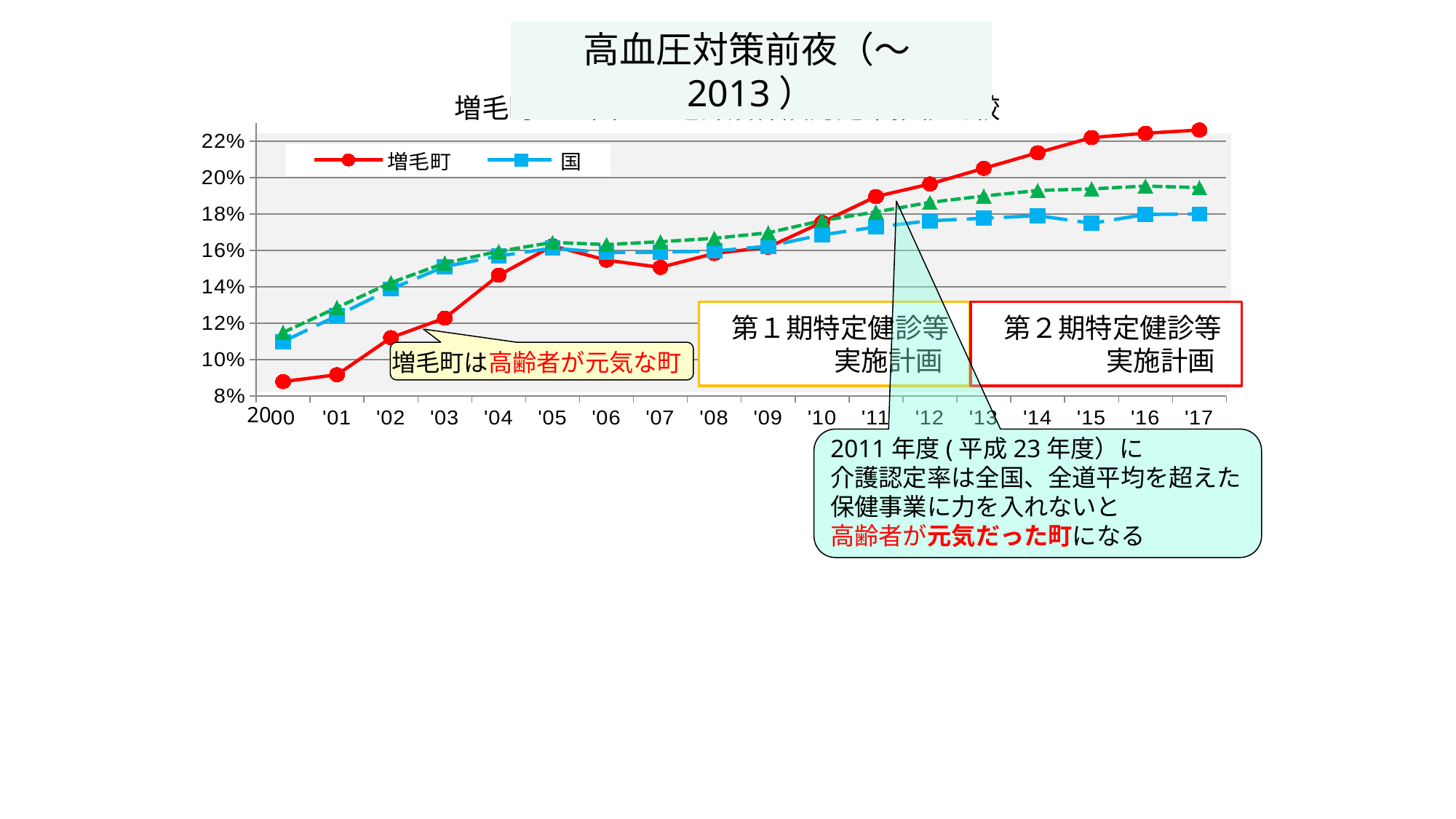
Which series does the red line with circle markers represent? 増毛町 In 2000, which is larger, the value for 増毛町 or the value for 国? 国 What kind of chart is shown on the slide? line chart How many years are plotted along the x axis of the chart? 18 In which year is the value for 増毛町 highest? '17 In which year is the value for 増毛町 lowest? 2000 Which series does the blue dashed line with square markers represent? 国 In '17, which is larger, the value for 増毛町 or the value for 国? 増毛町 Is the value for 増毛町 in '17 greater or less than 22%? greater Is the value for 増毛町 in '14 greater or less than 20%? greater Is the value for 増毛町 in 2000 greater or less than 10%? less